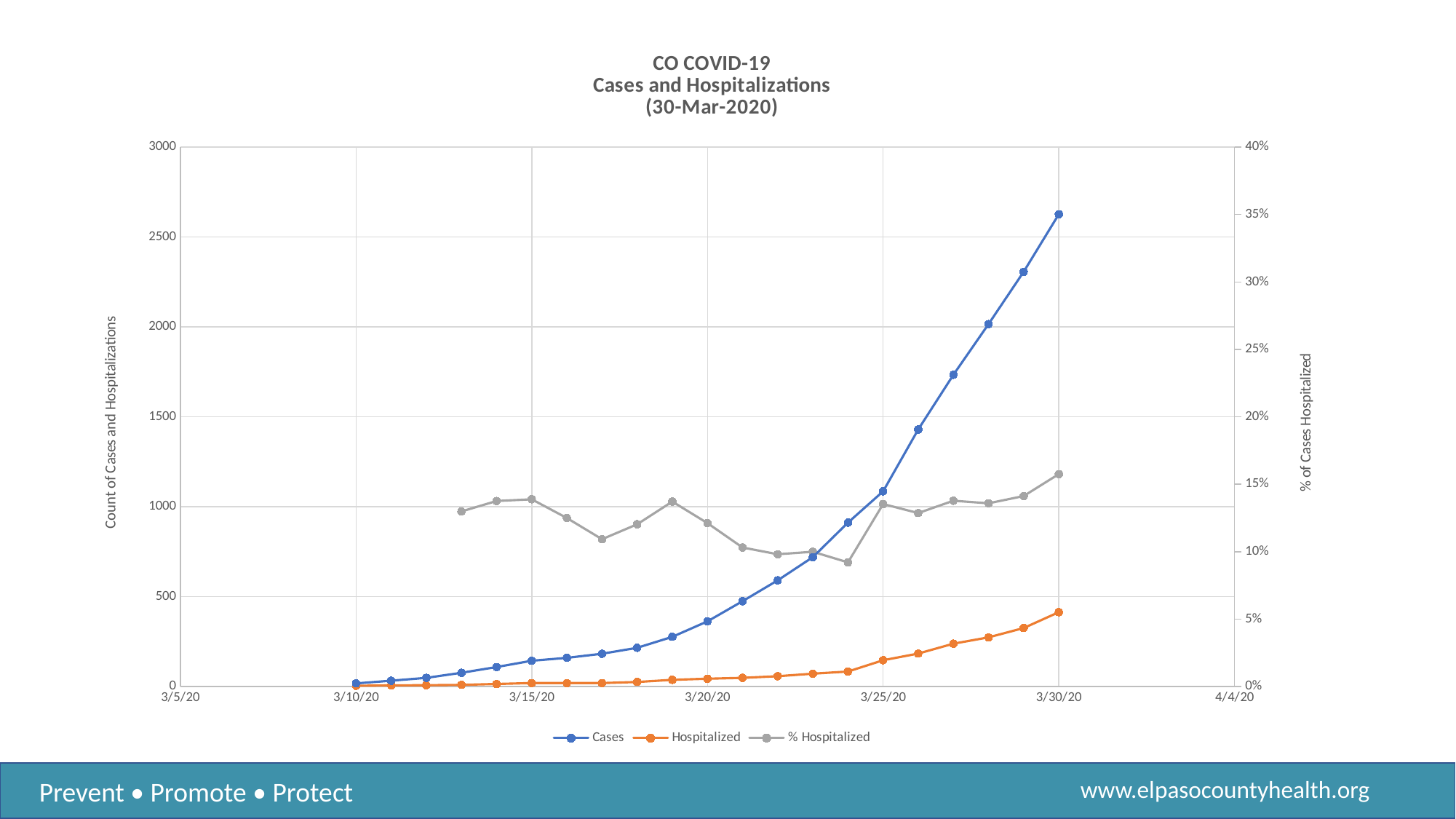
Which series reaches the highest value on the left-hand axis? Cases Do the values for Cases rise or fall from 3/10/20 to 3/30/20? rise Is the value for Cases on 3/30/20 greater or less than 2500? greater Is the value for Cases on 3/20/20 greater or less than 500? less What kind of chart is shown on the slide? line chart Is the value for Cases on 3/25/20 greater or less than 500? greater What is the label of the right-hand vertical axis? % of Cases Hospitalized What is the title of the chart? CO COVID-19 Cases and Hospitalizations (30-Mar-2020) How many series does the legend list? 3 On 3/30/20, which is larger, Cases or Hospitalized? Cases